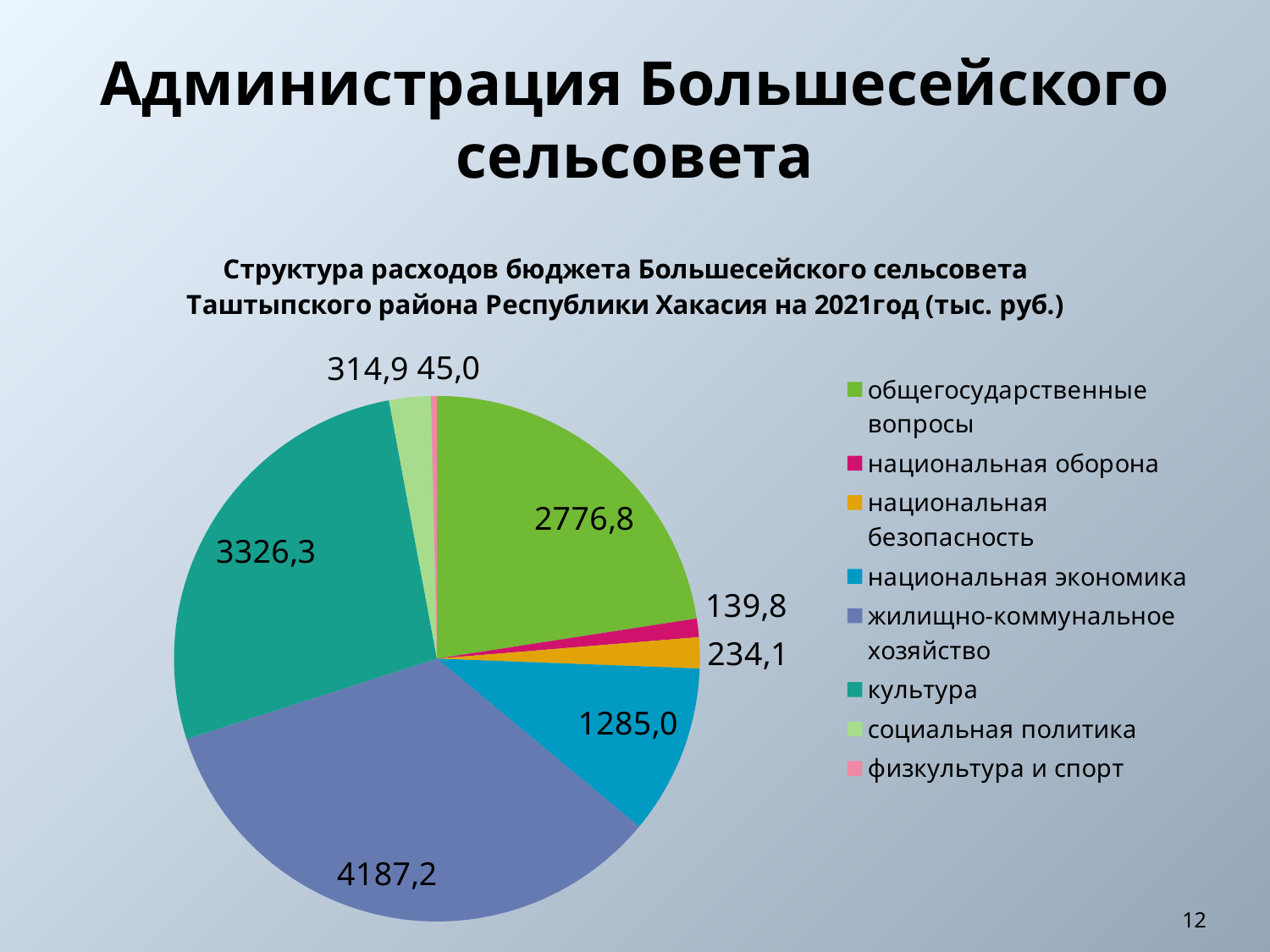
How many categories does the pie chart have? 8 Which is larger: общегосударственные вопросы or национальная экономика? общегосударственные вопросы Which category has the largest slice? жилищно-коммунальное хозяйство What is the value for жилищно-коммунальное хозяйство? 4187,2 Which category has the smallest slice? физкультура и спорт What is the value for физкультура и спорт? 45,0 What type of chart is shown on the slide? pie chart What is the difference between the values for жилищно-коммунальное хозяйство and культура? 860,9 What is the value for культура? 3326,3 What is the value for национальная экономика? 1285,0 What unit is stated in the chart title? тыс. руб. What is the value for социальная политика? 314,9